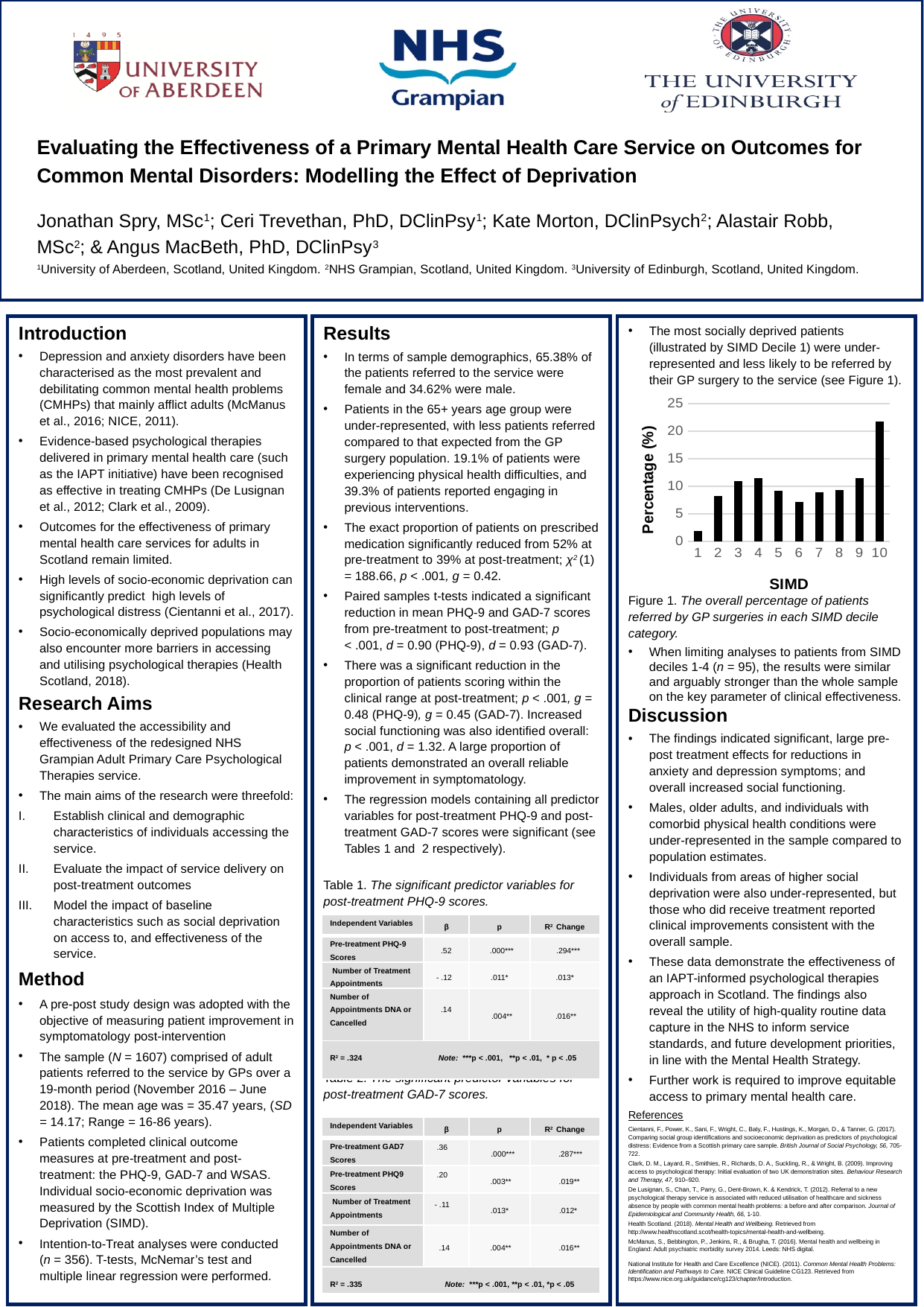
In Figure 1, is the value for SIMD decile 10 greater or less than 20? greater What kind of chart is shown in Figure 1? bar chart How many SIMD decile categories are plotted in Figure 1? 10 In Figure 1, which has the larger percentage: SIMD decile 3 or SIMD decile 6? 3 In Figure 1, is the value for SIMD decile 6 greater or less than 5? greater In Figure 1, is the value for SIMD decile 2 greater or less than 10? less Which SIMD decile has the lowest percentage of patients in Figure 1? 1 What is the label on the horizontal axis of Figure 1? SIMD What is the label on the vertical axis of Figure 1? Percentage (%) Which SIMD decile has the highest percentage of patients in Figure 1? 10